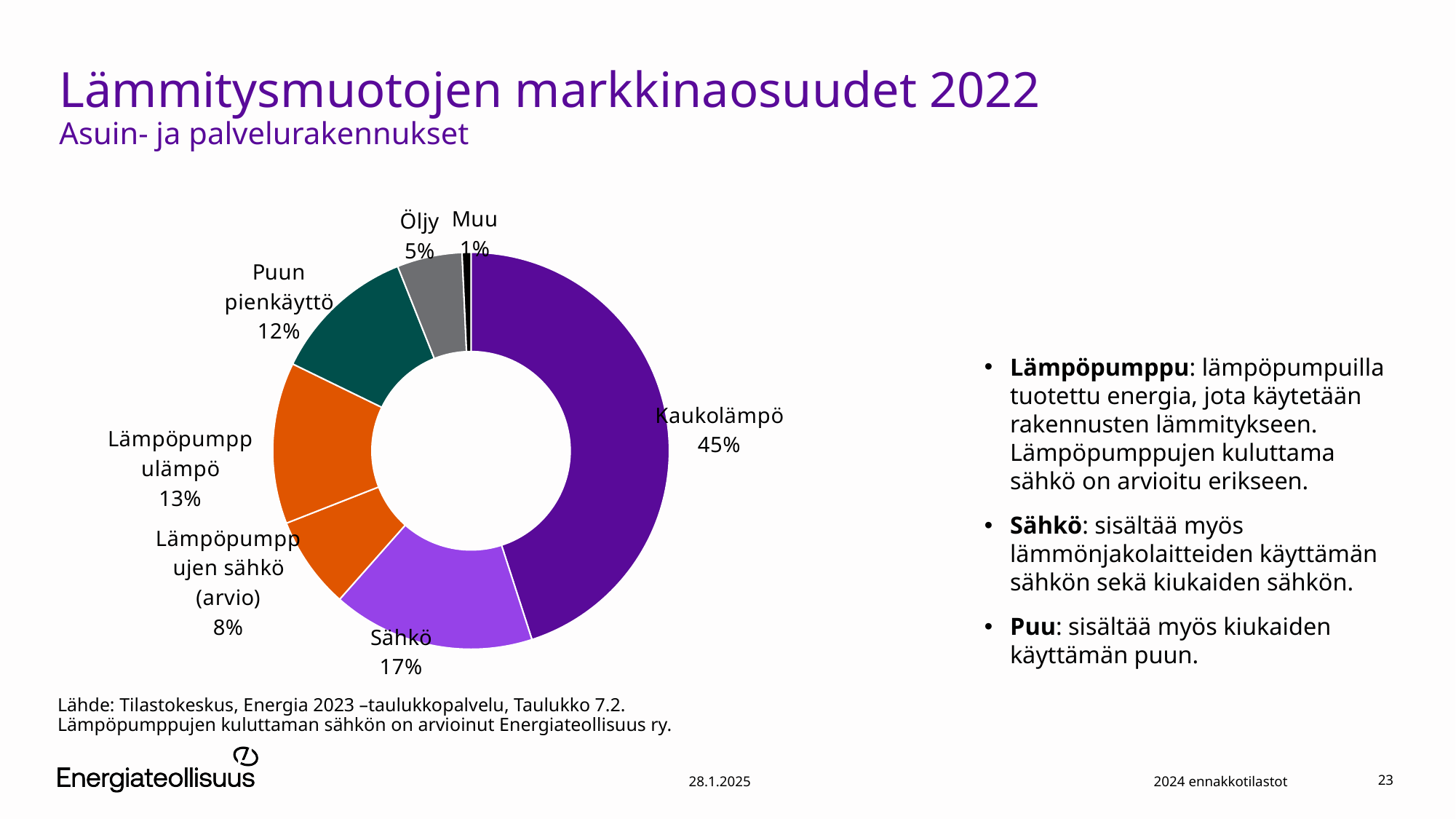
How many categories are shown in the chart? 7 What kind of chart is shown on the slide? Pie chart (donut) What is the title of the slide? Lämmitysmuotojen markkinaosuudet 2022 What is the difference in percentage points between Kaukolämpö and Sähkö? 28 What share does Öljy have in the chart? 5% What share does Kaukolämpö have in the chart? 45% Which category has the largest share in the chart? Kaukolämpö What share does Lämpöpumppujen sähkö (arvio) have in the chart? 8% Which has a larger share, Lämpöpumppulämpö or Puun pienkäyttö? Lämpöpumppulämpö Which category has the smallest share in the chart? Muu What share does Sähkö have in the chart? 17% What share does Puun pienkäyttö have in the chart? 12%